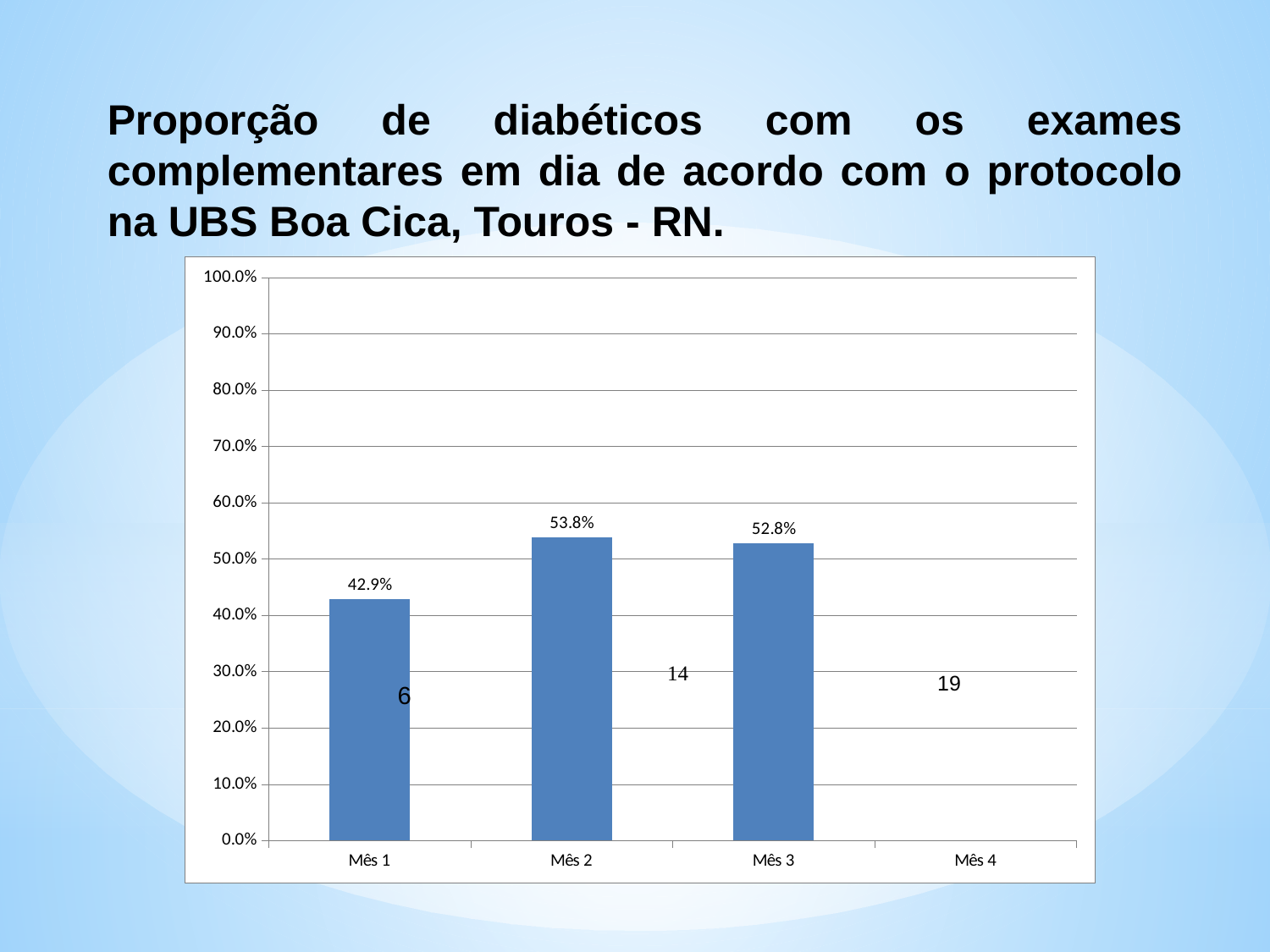
What is the difference between the values for Mês 2 and Mês 1? 10.9% What is the value for Mês 1? 42.9% Is the value for Mês 1 greater or less than 50.0%? less What is the value for Mês 3? 52.8% What kind of chart is shown on the slide? bar chart What is the value for Mês 2? 53.8% Which month has the highest value? Mês 2 What is the difference between the values for Mês 2 and Mês 3? 1.0% Which month with a plotted bar has the lowest value? Mês 1 Does the value rise or fall from Mês 1 to Mês 2? rise How many bars are plotted in the chart? 3 Which is larger, the value for Mês 1 or the value for Mês 3? Mês 3